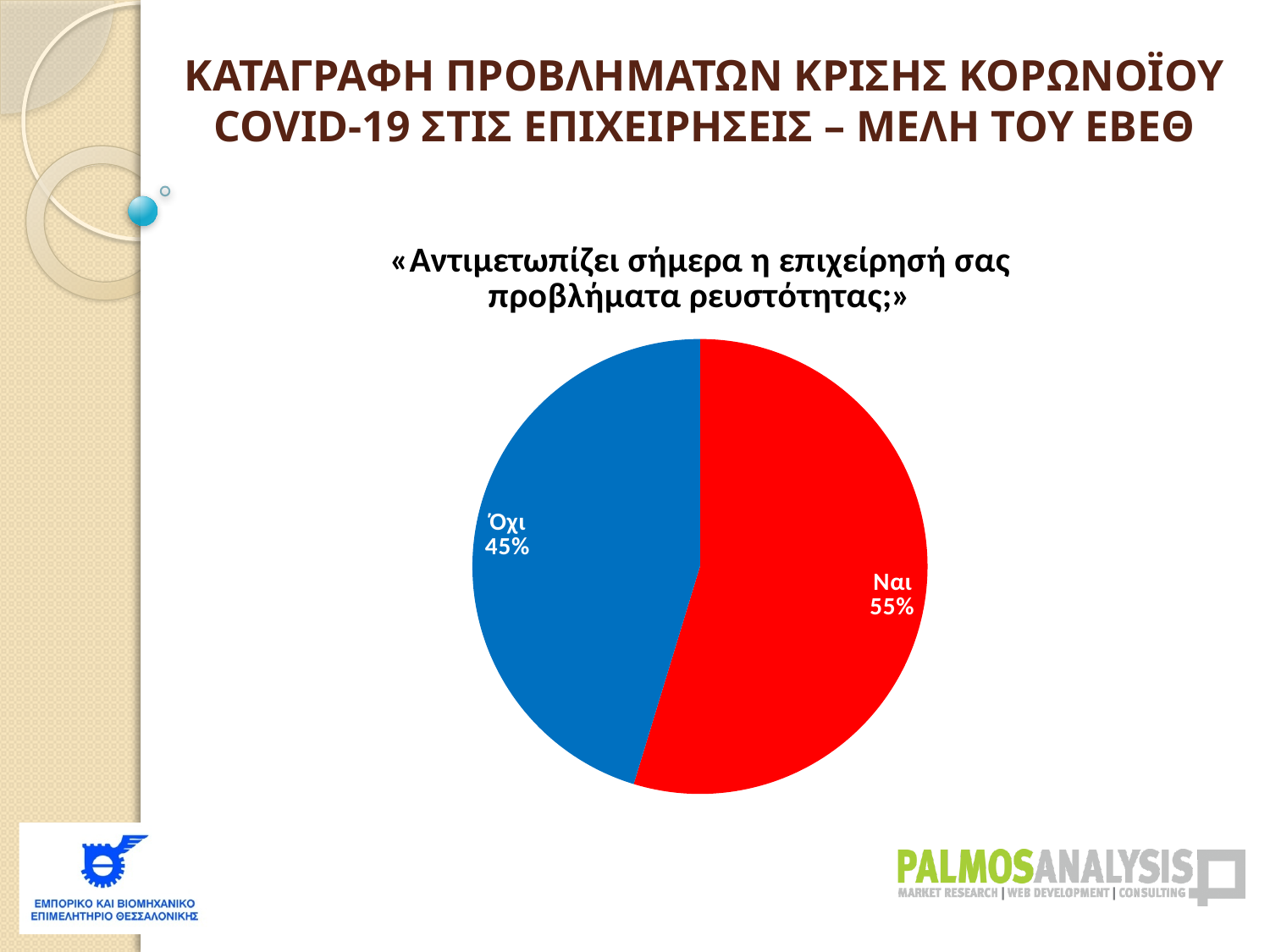
How many slices does the pie chart have? 2 What colour is the "Ναι" slice? red What share of the pie does the "Όχι" slice represent? 45% Which answer has the smallest share of the pie? Όχι What question does the chart title ask? «Αντιμετωπίζει σήμερα η επιχείρησή σας προβλήματα ρευστότητας;» Is the share for "Ναι" greater or less than 50%? greater What is the difference in percentage points between the "Ναι" and "Όχι" slices? 10 Which answer has the largest share of the pie? Ναι What kind of chart is shown on the slide? pie chart What percentage of respondents answered "Ναι"? 55% What percentage of respondents answered "Όχι"? 45% Which is larger, the "Ναι" slice or the "Όχι" slice? Ναι